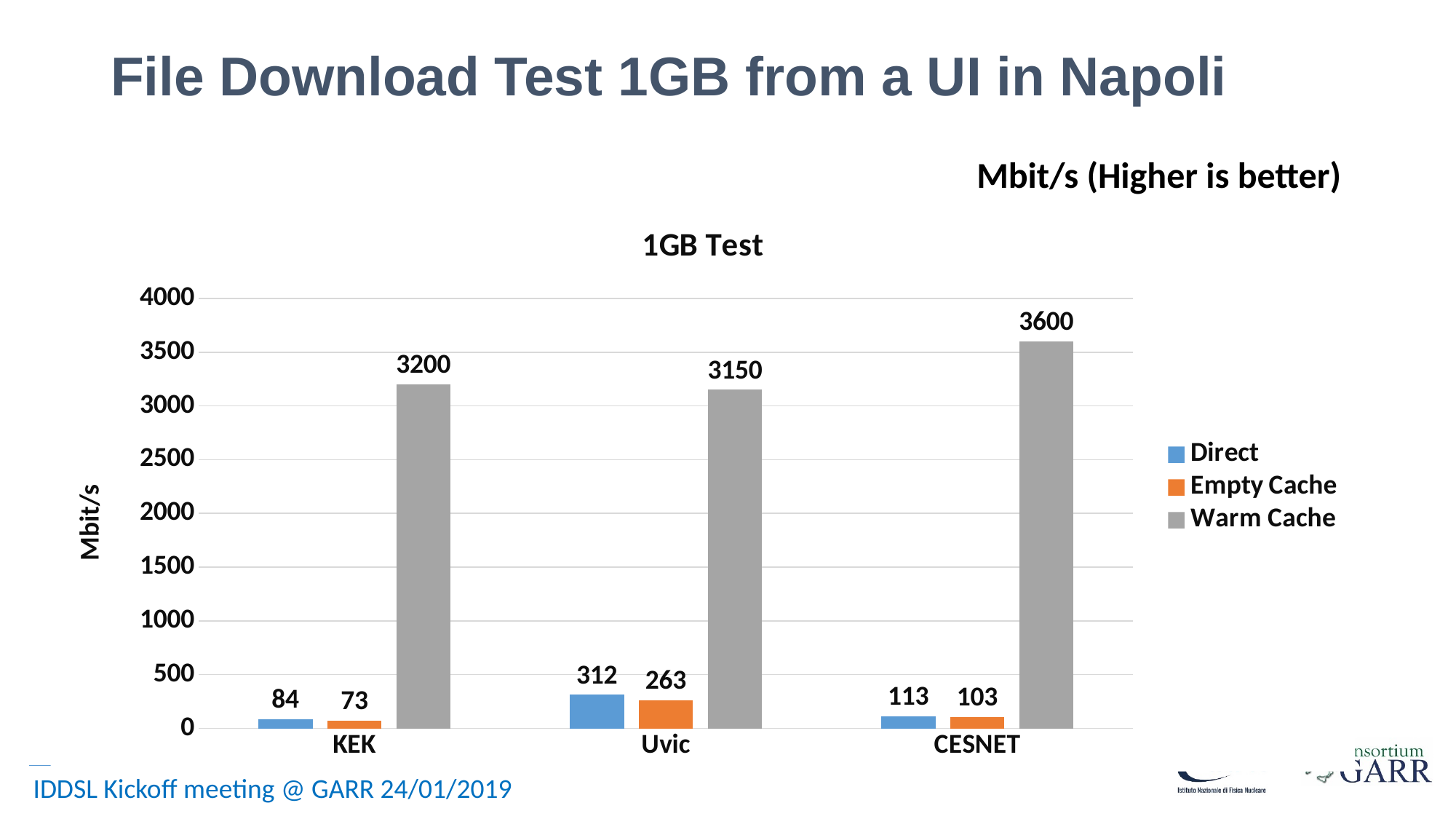
Which site has the highest Warm Cache value? CESNET What is the Empty Cache value for KEK? 73 Which is larger, the Direct value for CESNET or the Direct value for Uvic? Uvic What kind of chart is shown? bar chart Which site has the lowest Direct value? KEK What is the difference between the Direct and Empty Cache values for Uvic? 49 How many sites are shown on the x axis? 3 Is the Warm Cache value for Uvic greater or less than 3000? greater What is the Direct value for Uvic? 312 What is the Warm Cache value for CESNET? 3600 How many series does the legend list? 3 What is the difference between the Warm Cache values for CESNET and KEK? 400